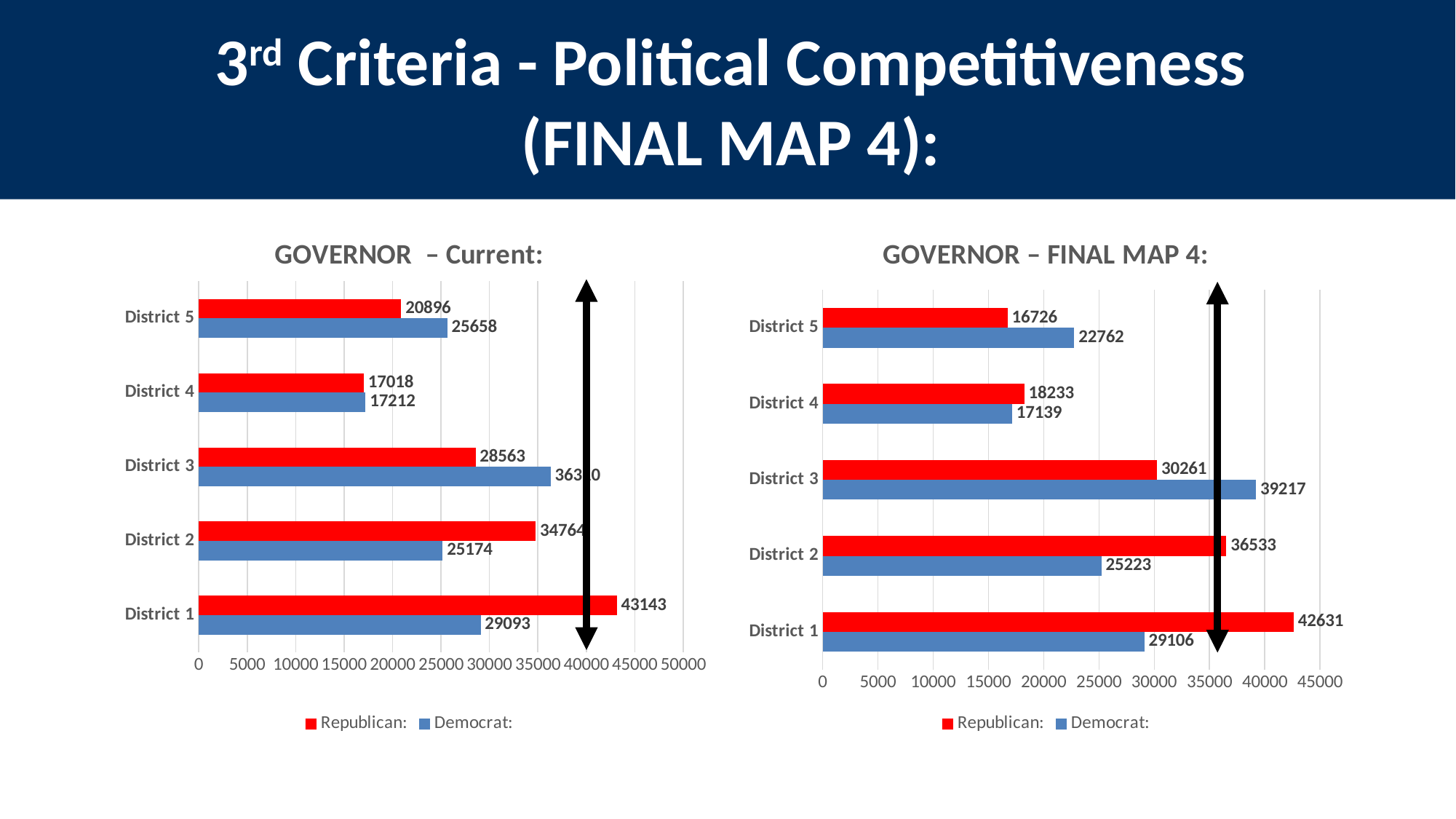
In the GOVERNOR – Current chart, what is the Republican value for District 1? 43143 In the GOVERNOR – FINAL MAP 4 chart, which is larger for District 4, the Republican value or the Democrat value? Republican What kind of chart is the GOVERNOR – FINAL MAP 4 chart? Bar chart In the GOVERNOR – Current chart, which district has the highest Republican value? District 1 How many series does the legend of the GOVERNOR – Current chart list? 2 How many districts are shown in the GOVERNOR – FINAL MAP 4 chart? 5 In the GOVERNOR – Current chart, is the Democrat value for District 3 greater or less than 35000? greater In the GOVERNOR – FINAL MAP 4 chart, what is the Republican value for District 5? 16726 In the GOVERNOR – FINAL MAP 4 chart, what is the Democrat value for District 3? 39217 In the GOVERNOR – Current chart, what is the difference between the Republican and Democrat values for District 2? 9590 In the GOVERNOR – FINAL MAP 4 chart, what is the difference between the Republican and Democrat values for District 1? 13525 In the GOVERNOR – FINAL MAP 4 chart, which district has the lowest Democrat value? District 4